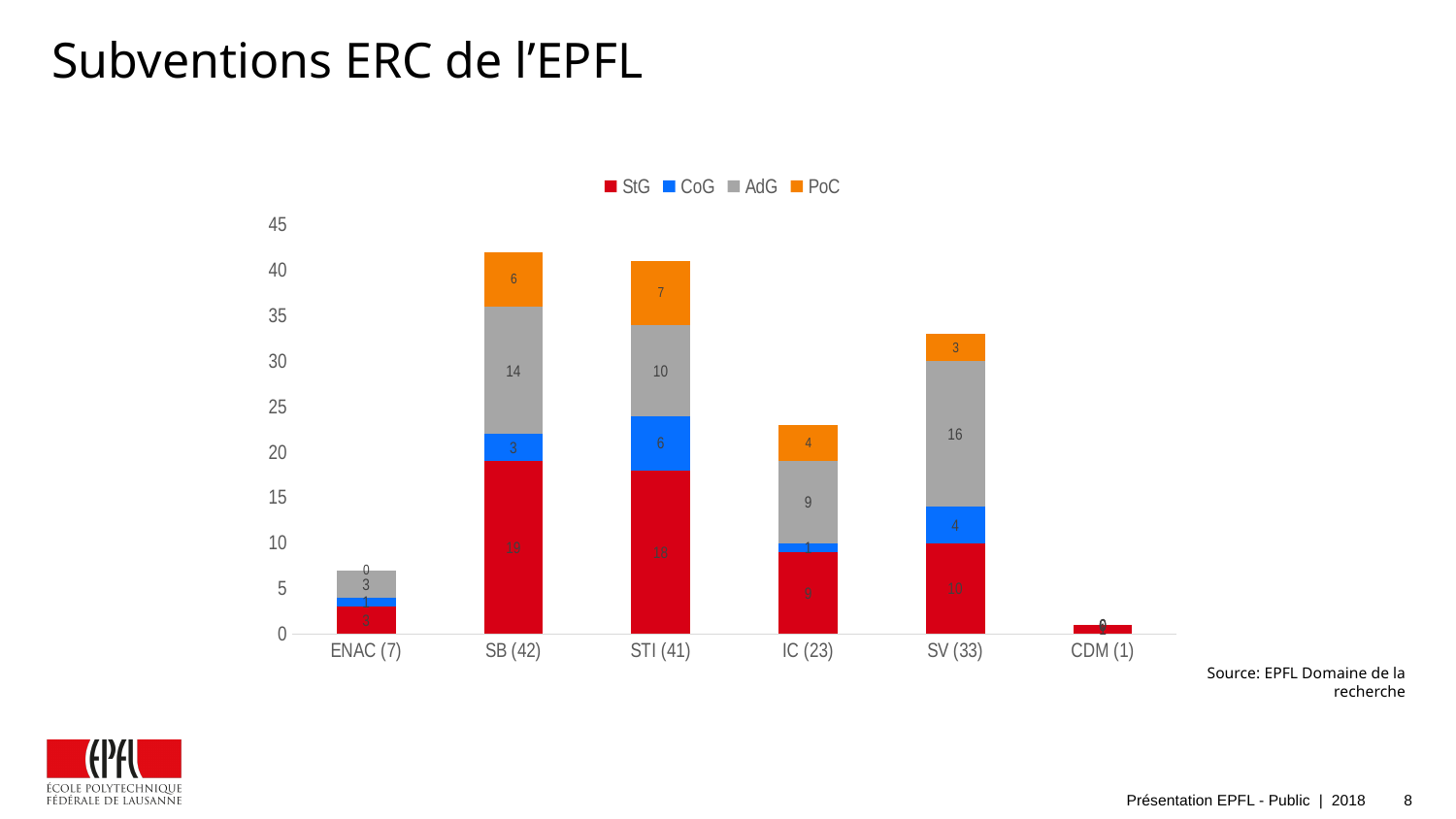
How many categories are shown on the x axis? 6 What is the CoG value for SV (33)? 4 What is the PoC value for STI (41)? 7 Which category has the tallest stacked bar? SB (42) Which category has the shortest stacked bar? CDM (1) What is the difference between the AdG values for SV (33) and STI (41)? 6 How many series does the legend list? 4 Which is larger, the StG value for SB (42) or the StG value for STI (41)? SB (42) What is the AdG value for SB (42)? 14 Which series is shown in orange in the legend? PoC What is the AdG value for IC (23)? 9 What kind of chart is shown on the slide? stacked bar chart